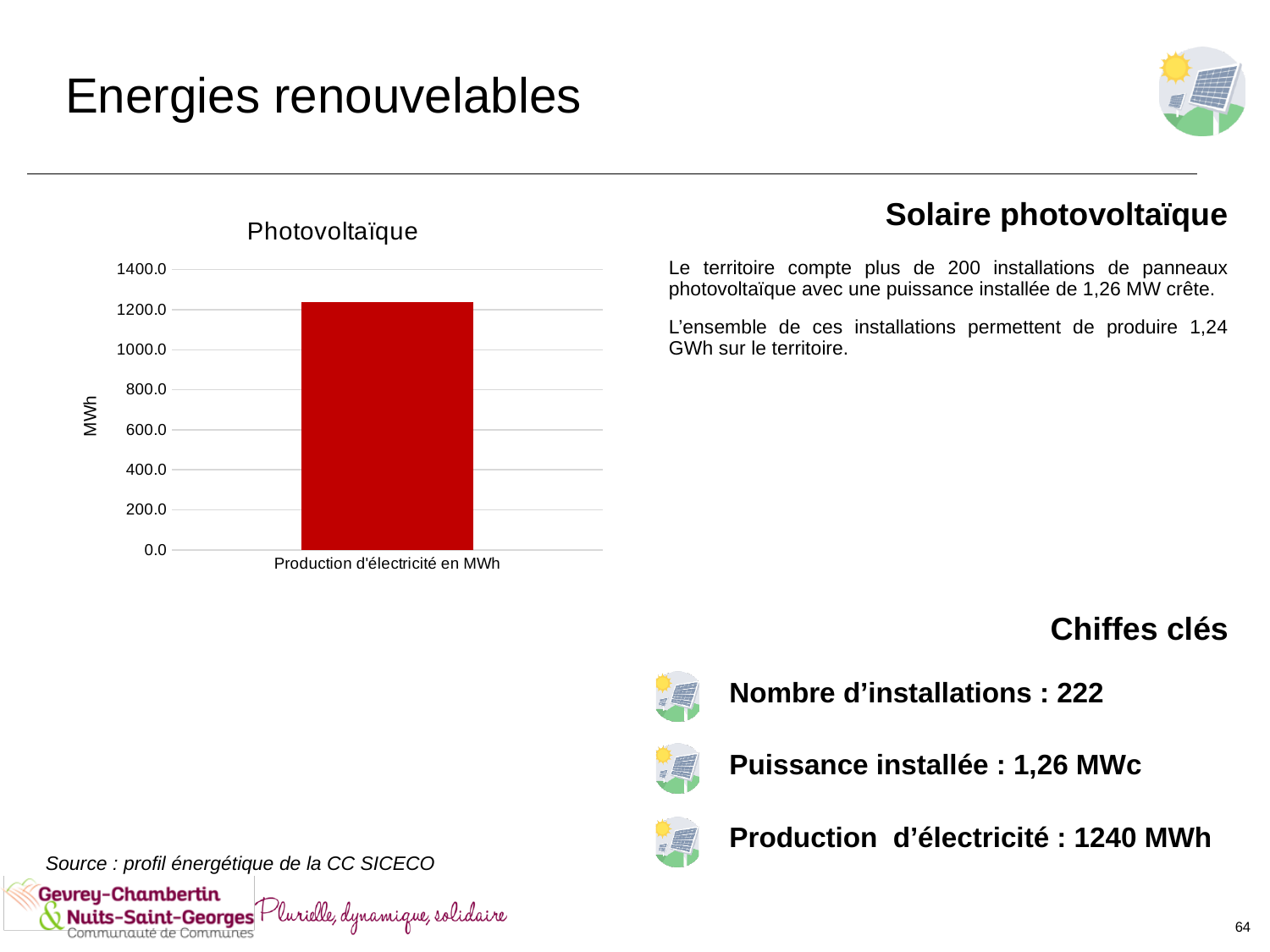
What is the maximum value shown on the y axis of the chart? 1400.0 What is the title of the chart? Photovoltaïque What kind of chart is shown on the slide? bar chart Is the value for Production d'électricité en MWh greater or less than 800? greater Is the value for Production d'électricité en MWh greater or less than 1400? less How many bars does the chart show? 1 Is the value for Production d'électricité en MWh greater or less than 1000? greater What is the label of the category on the x axis of the chart? Production d'électricité en MWh